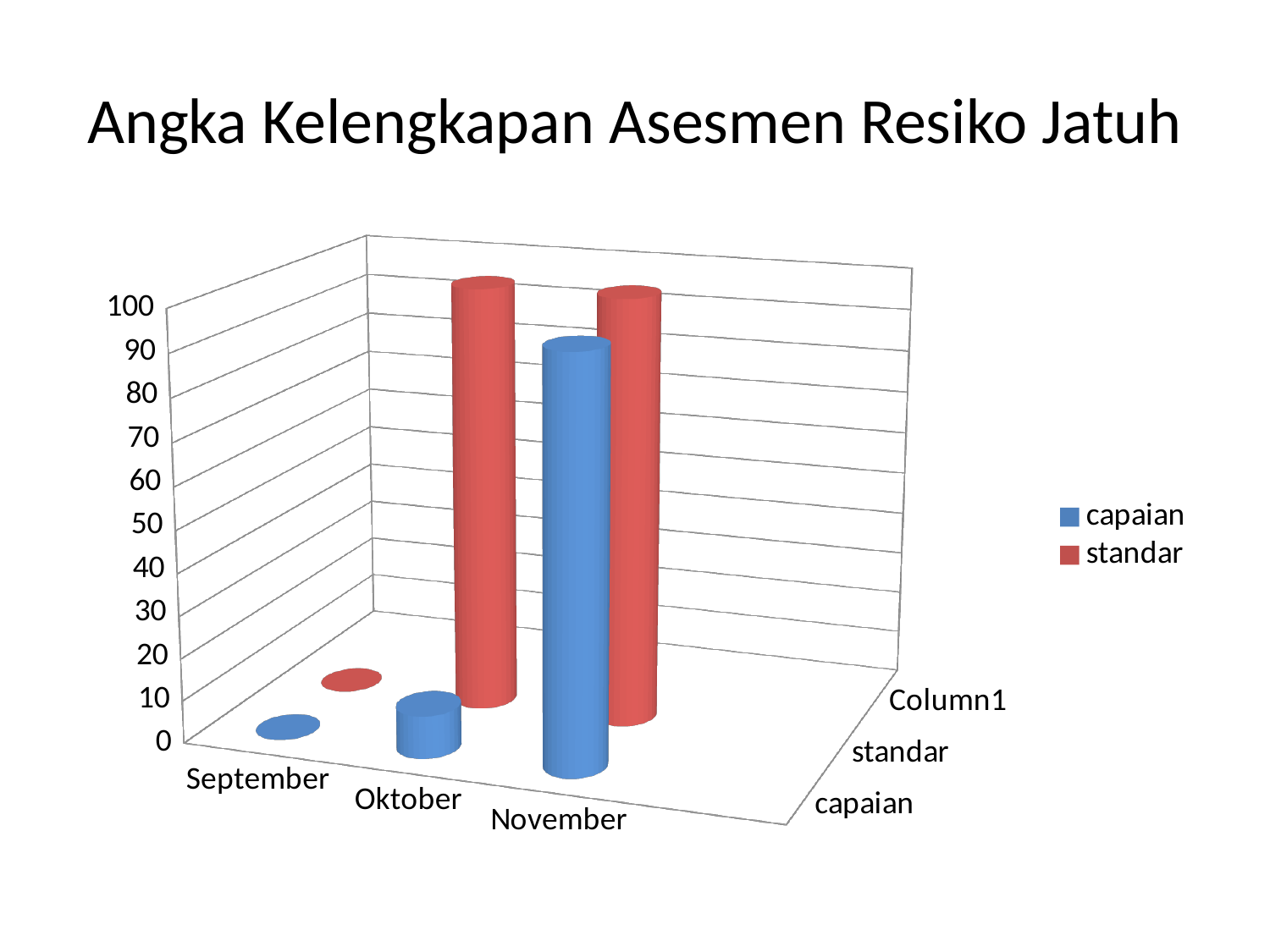
What kind of chart is shown on the slide? bar chart Which colour represents the 'standar' series in the chart? red Which month has the lowest 'capaian' value? September Is the 'capaian' value for November greater or less than 50? greater How many series does the legend list? 2 Is the 'standar' value for Oktober greater or less than 50? greater What is the title of the chart? Angka Kelengkapan Asesmen Resiko Jatuh Is the 'capaian' value for Oktober greater or less than 50? less Does the 'capaian' series rise or fall from September to November? rise Which is larger, the 'capaian' value for November or the 'capaian' value for Oktober? November How many months are shown on the x axis of the chart? 3 Which month has the highest 'capaian' value? November